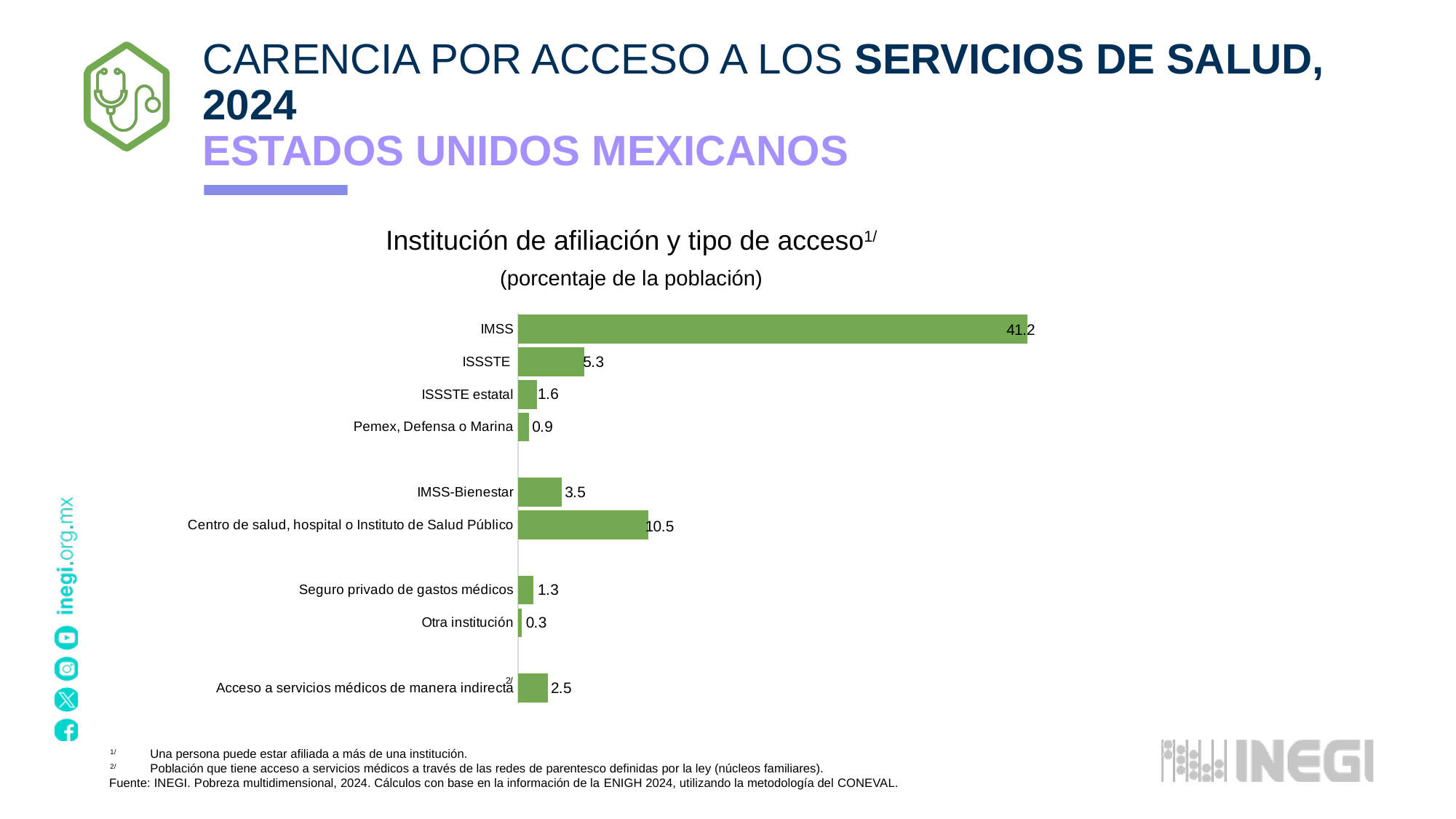
What is the value for Centro de salud, hospital o Instituto de Salud Público? 10.5 What is the difference between the values for IMSS-Bienestar and Seguro privado de gastos médicos? 2.2 Which category has the highest value? IMSS What is the value for Pemex, Defensa o Marina? 0.9 What is the difference between the values for IMSS and ISSSTE? 35.9 How many categories are shown in the chart? 9 What kind of chart is shown on the slide? Bar chart Which category has the lowest value? Otra institución What unit is stated in the chart subtitle? porcentaje de la población What is the value for Acceso a servicios médicos de manera indirecta? 2.5 What is the value for IMSS? 41.2 Which is larger, the value for ISSSTE or the value for IMSS-Bienestar? ISSSTE